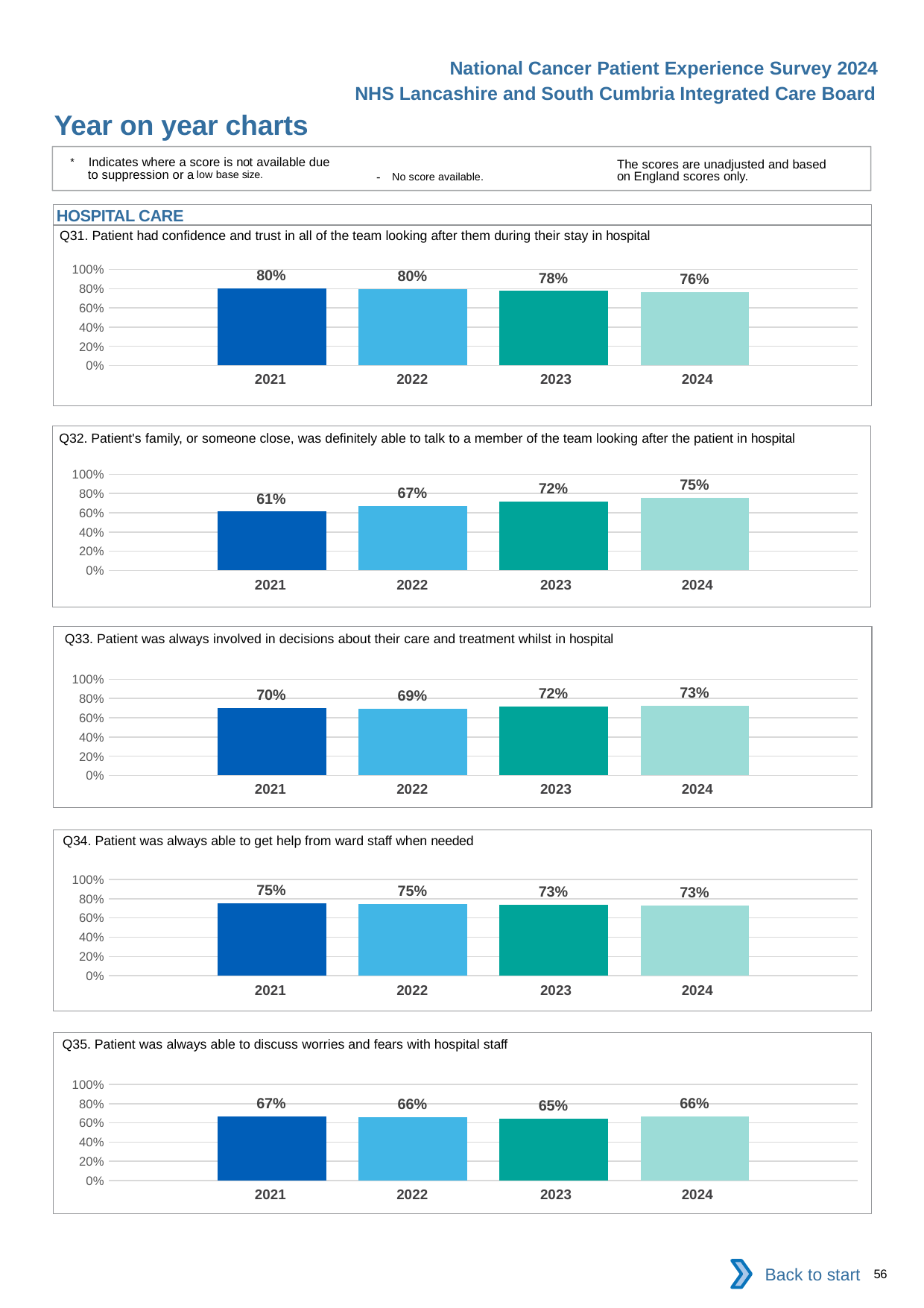
How many years are shown in the Q31 chart? 4 In the Q34 chart (patient was always able to get help from ward staff), is the 2021 value larger or smaller than the 2023 value? larger In the Q32 chart (patient's family was definitely able to talk to a member of the team), what is the difference between the 2024 and 2021 values? 14 percentage points In the Q32 chart (patient's family was definitely able to talk to a member of the team), do the values rise or fall from 2021 to 2024? Rise In the Q33 chart (patient was always involved in decisions about their care), which year has the highest value? 2024 In the Q31 chart (patient had confidence and trust in all of the team), what is the value for 2024? 76% In the Q35 chart (patient was always able to discuss worries and fears), what is the difference between the 2021 and 2023 values? 2 percentage points What kind of chart is used for Q32? Bar chart In the Q34 chart (patient was always able to get help from ward staff), what is the value for 2021? 75% In the Q35 chart (patient was always able to discuss worries and fears), which year has the lowest value? 2023 In the Q32 chart (patient's family was definitely able to talk to a member of the team), which year has the lowest value? 2021 In the Q33 chart (patient was always involved in decisions about their care), what is the value for 2022? 69%